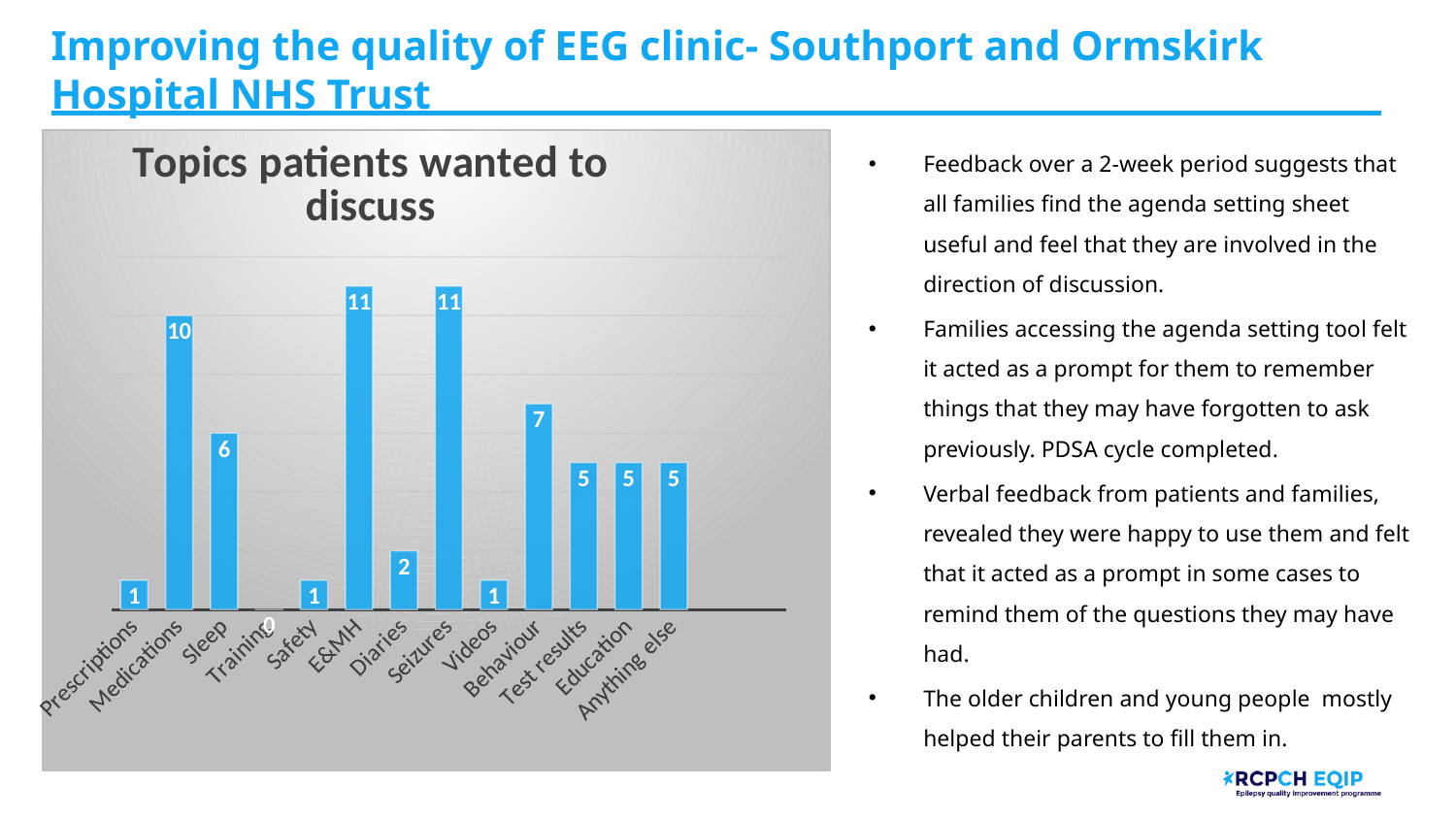
Which topic has the lowest value in the 'Topics patients wanted to discuss' chart? Training How many topics are shown in the 'Topics patients wanted to discuss' chart? 13 Which has a larger value in the 'Topics patients wanted to discuss' chart, Behaviour or Test results? Behaviour What is the difference between the values for Seizures and Behaviour in the 'Topics patients wanted to discuss' chart? 4 What kind of chart is 'Topics patients wanted to discuss'? Bar chart What is the value for Diaries in the 'Topics patients wanted to discuss' chart? 2 Which two topics share the highest value in the 'Topics patients wanted to discuss' chart? E&MH and Seizures What is the value for Medications in the 'Topics patients wanted to discuss' chart? 10 What is the difference between the values for Medications and Sleep in the 'Topics patients wanted to discuss' chart? 4 What is the value for Behaviour in the 'Topics patients wanted to discuss' chart? 7 What is the value for Sleep in the 'Topics patients wanted to discuss' chart? 6 What is the title of the chart on the slide? Topics patients wanted to discuss